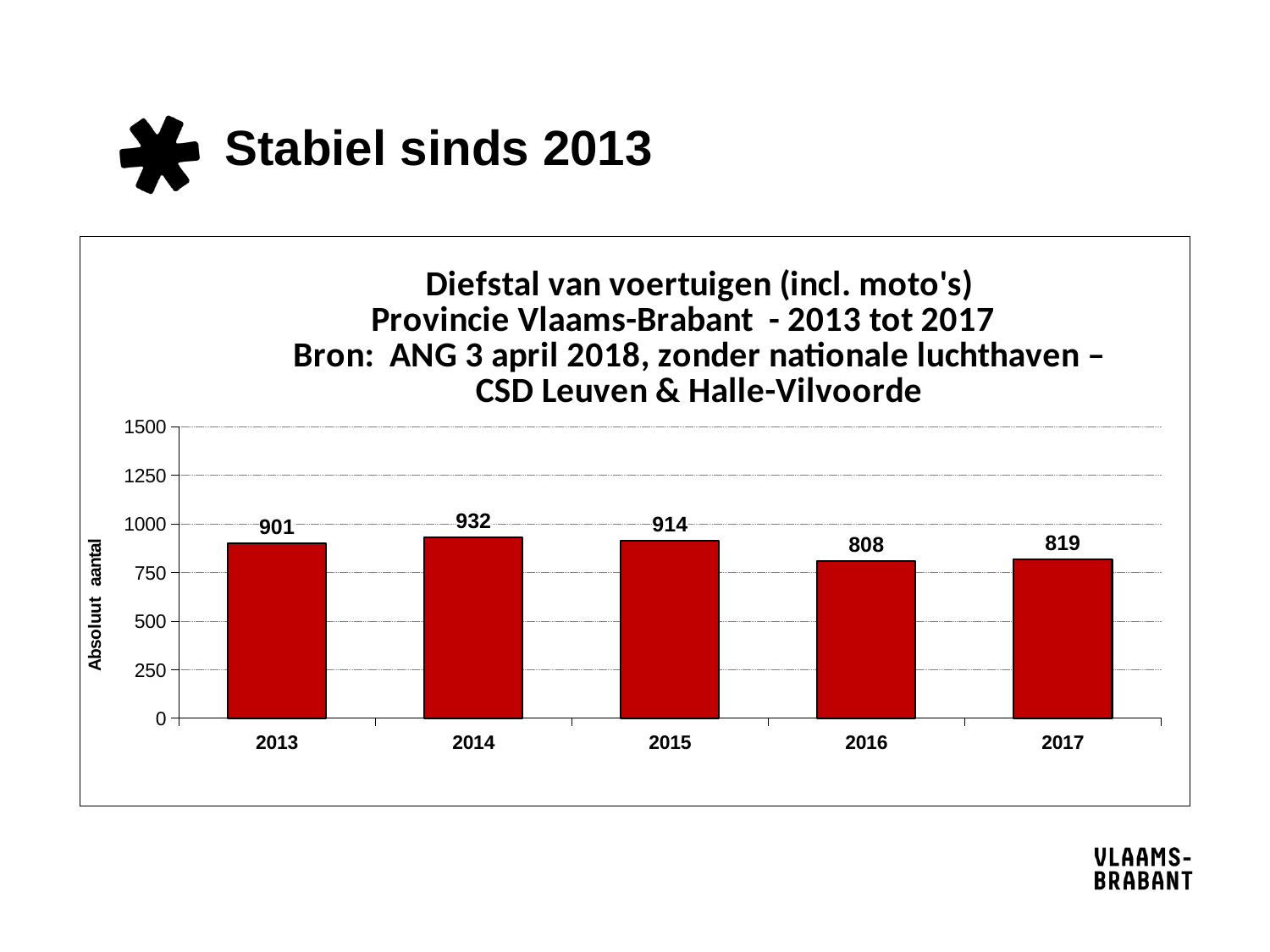
What is the value for 2016? 808 Which is larger, the value for 2013 or the value for 2017? 2013 What is the value for 2013? 901 Which year has the highest value? 2014 How many years are shown on the x axis? 5 What is the label of the vertical axis? Absoluut aantal What is the value for 2017? 819 Which year has the lowest value? 2016 Is the value for 2014 greater or less than 1000? less What kind of chart is shown? bar chart What is the difference between the values for 2014 and 2016? 124 What is the difference between the values for 2015 and 2013? 13